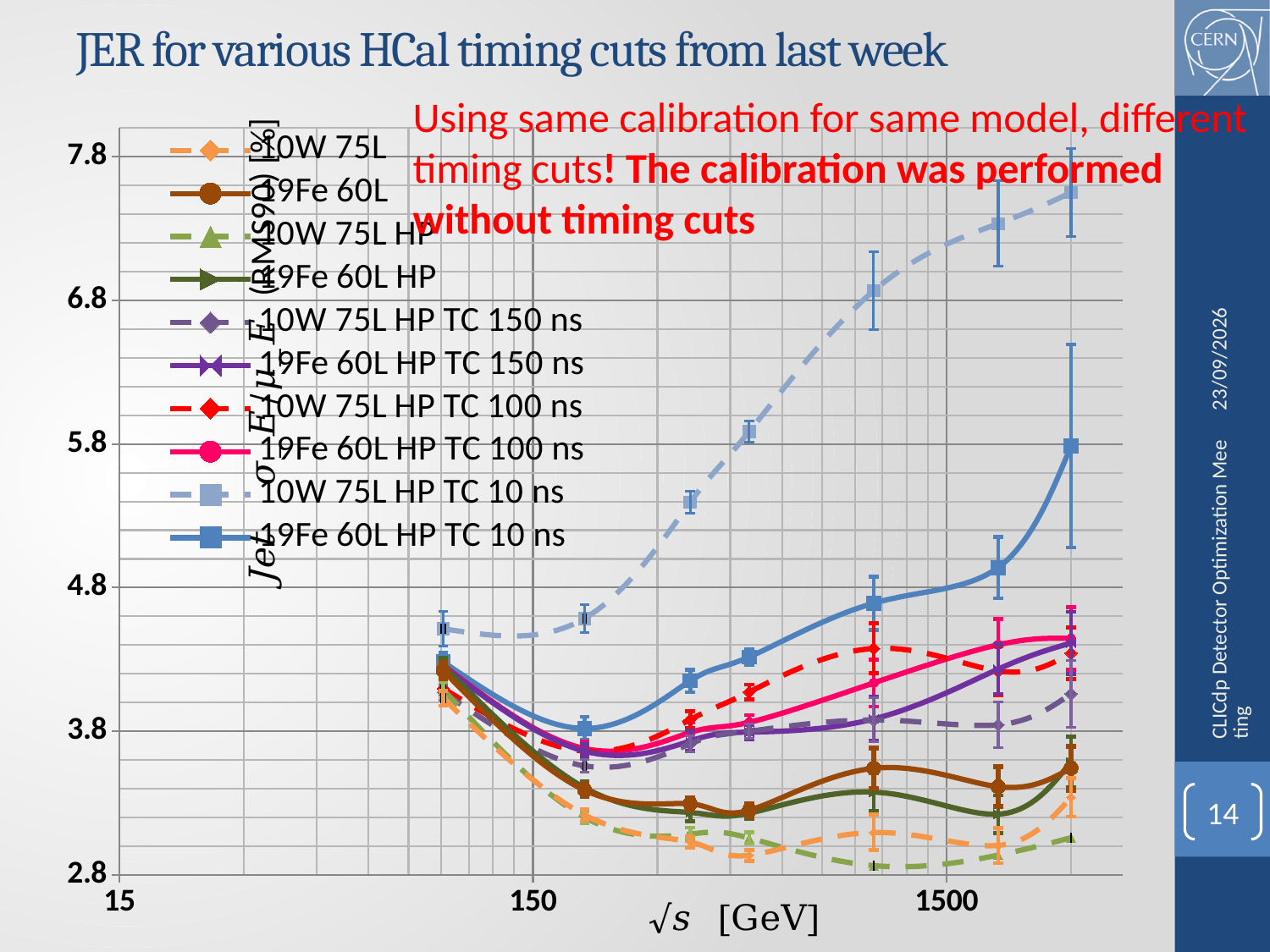
Is the value of the 19Fe 60L series at its rightmost point greater or less than 3.8? less Is the value of the 10W 75L HP series at its rightmost point greater or less than 3.8? less Is the value of the 19Fe 60L HP TC 10 ns series at its rightmost point greater or less than 4.8? greater What quantity is shown on the x axis of the chart? √s [GeV] Does the 10W 75L HP TC 10 ns series rise or fall as √s increases beyond 150 GeV? rise How many series does the legend list? 10 Which series has the lowest value at the rightmost point of the chart? 10W 75L HP What kind of chart is shown on the slide? line chart At the rightmost point, which series has the larger value: 19Fe 60L HP TC 10 ns or 19Fe 60L HP TC 100 ns? 19Fe 60L HP TC 10 ns Which series reaches the highest value on the chart? 10W 75L HP TC 10 ns